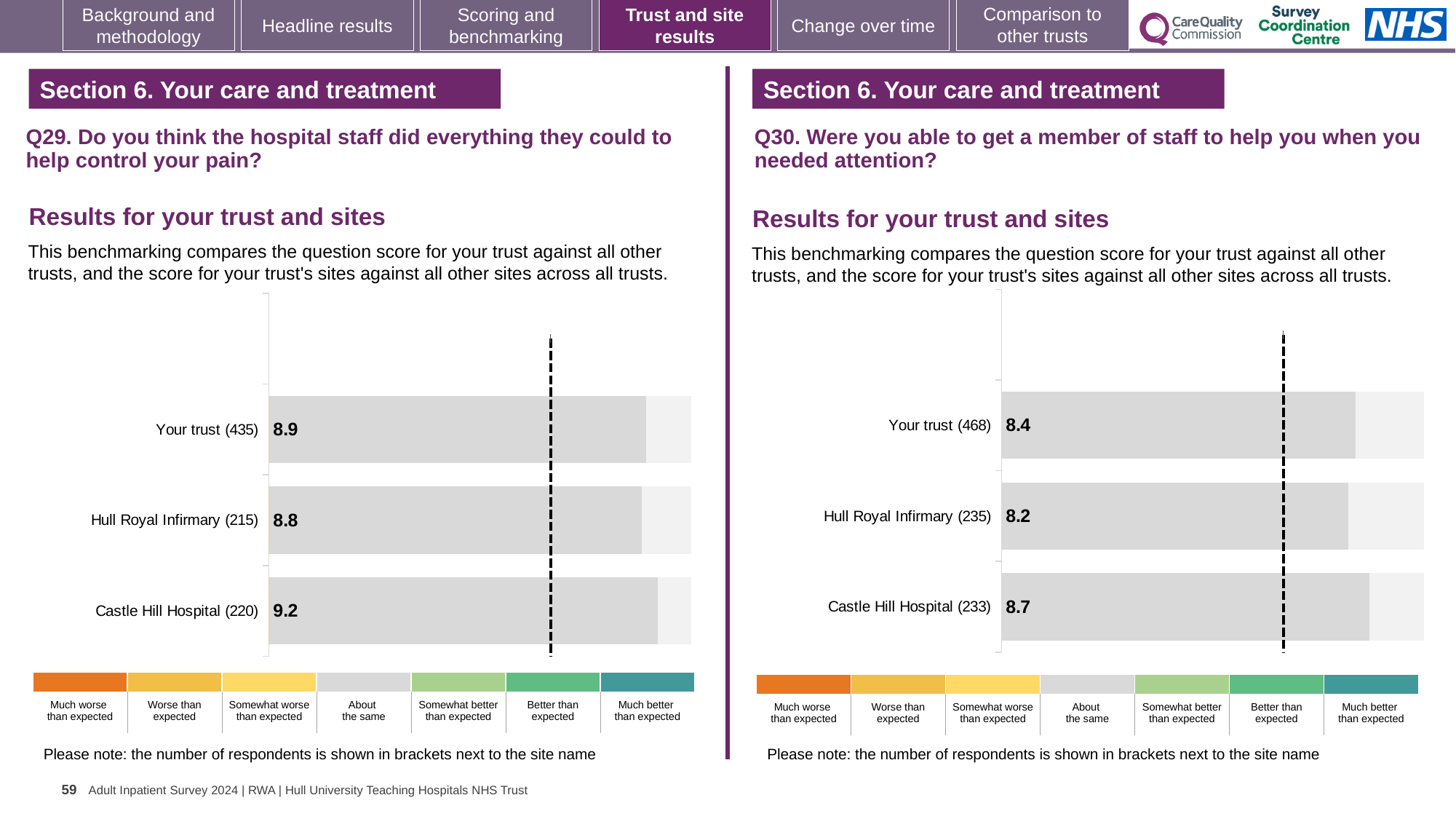
In the Q29 chart on the left, what is the score for Your trust? 8.9 In the Q29 chart on the left, how many respondents are shown for Hull Royal Infirmary? 215 How many bars are plotted in the Q30 chart on the right? 3 In the Q30 chart on the right, what is the difference between the scores for Castle Hill Hospital and Your trust? 0.3 In the Q29 chart on the left, what is the score for Castle Hill Hospital? 9.2 In the Q30 chart on the right, which has the higher score, Castle Hill Hospital or Hull Royal Infirmary? Castle Hill Hospital In the Q30 chart on the right, which site or trust has the lowest score? Hull Royal Infirmary In the Q30 chart on the right, what is the score for Your trust? 8.4 In the Q30 chart on the right, what is the score for Hull Royal Infirmary? 8.2 In the Q29 chart on the left, what is the difference between the scores for Castle Hill Hospital and Hull Royal Infirmary? 0.4 What kind of chart is used for the Q29 results on the left? Bar chart In the Q29 chart on the left, which site or trust has the highest score? Castle Hill Hospital